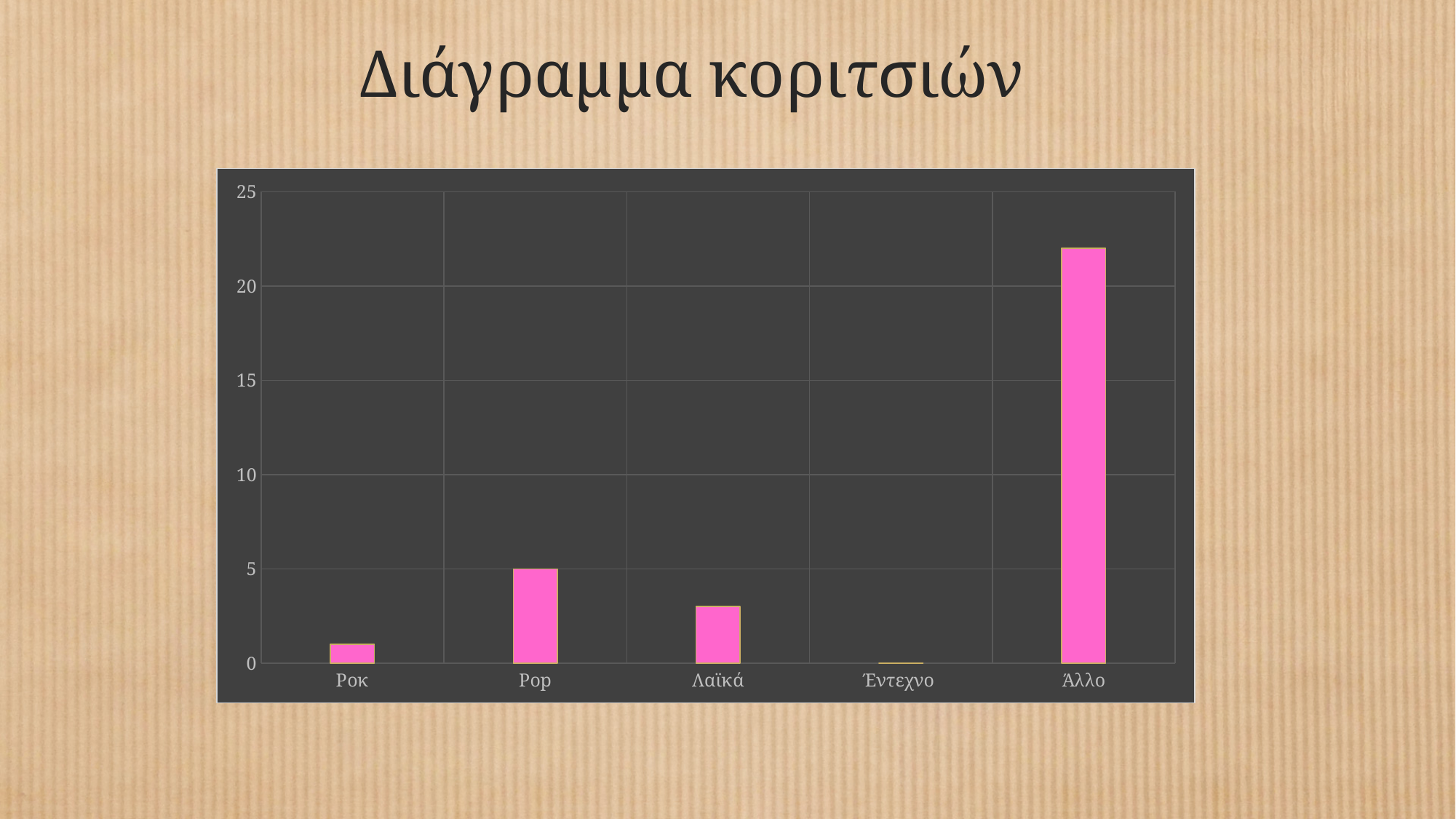
What is the value for Pop in the chart? 5 What kind of chart is shown on the slide? bar chart How many categories are shown on the x axis of the chart? 5 Which is larger, the value for Ροκ or the value for Άλλο? Άλλο Is the value for Ροκ greater or less than 5? less Which category has the lowest value in the chart? Έντεχνο Which category has the highest value in the chart? Άλλο What is the title of the slide containing the chart? Διάγραμμα κοριτσιών Is the value for Άλλο greater or less than 20? greater What is the value for Έντεχνο in the chart? 0 Which is larger, the value for Pop or the value for Λαϊκά? Pop Is the value for Λαϊκά greater or less than 5? less